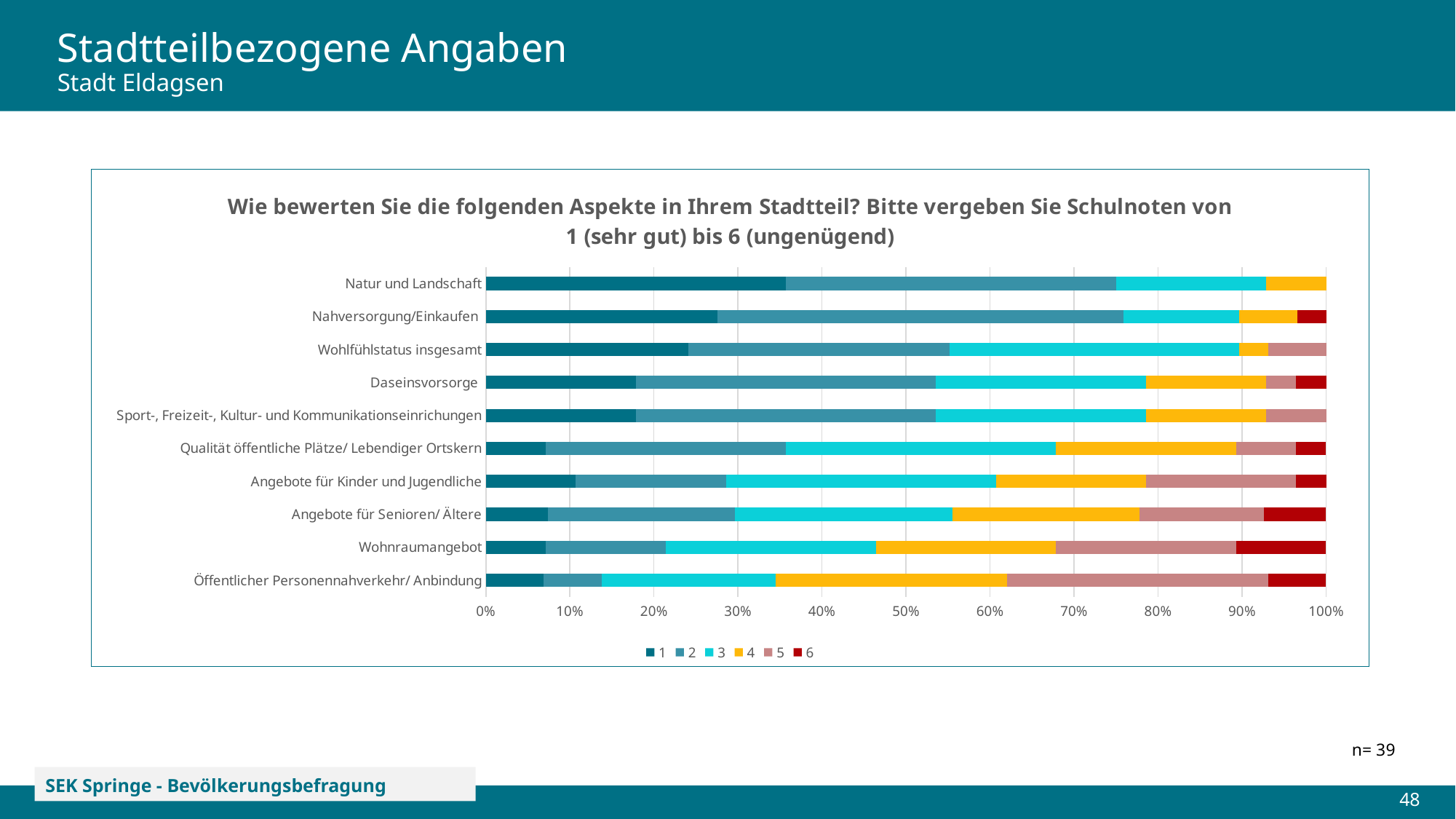
What kind of chart is shown on the slide? stacked bar chart How many series (grades) does the chart legend list? 6 Which category has the largest share of grade 6 (the dark red segment)? Wohnraumangebot Is the share of grade 1 for Natur und Landschaft greater or less than 30%? greater Is the share of grade 1 for Wohlfühlstatus insgesamt greater or less than 20%? greater Which category has the largest share of grade 1 (the darkest segment)? Natur und Landschaft How many aspects (categories) are listed on the vertical axis of the chart? 10 Is the share of grade 1 for Öffentlicher Personennahverkehr/ Anbindung greater or less than 10%? less Which has the larger share of grade 1: Natur und Landschaft or Wohnraumangebot? Natur und Landschaft What is the sample size (n) stated on the slide? n= 39 What value does each stacked bar in the chart add up to? 100%